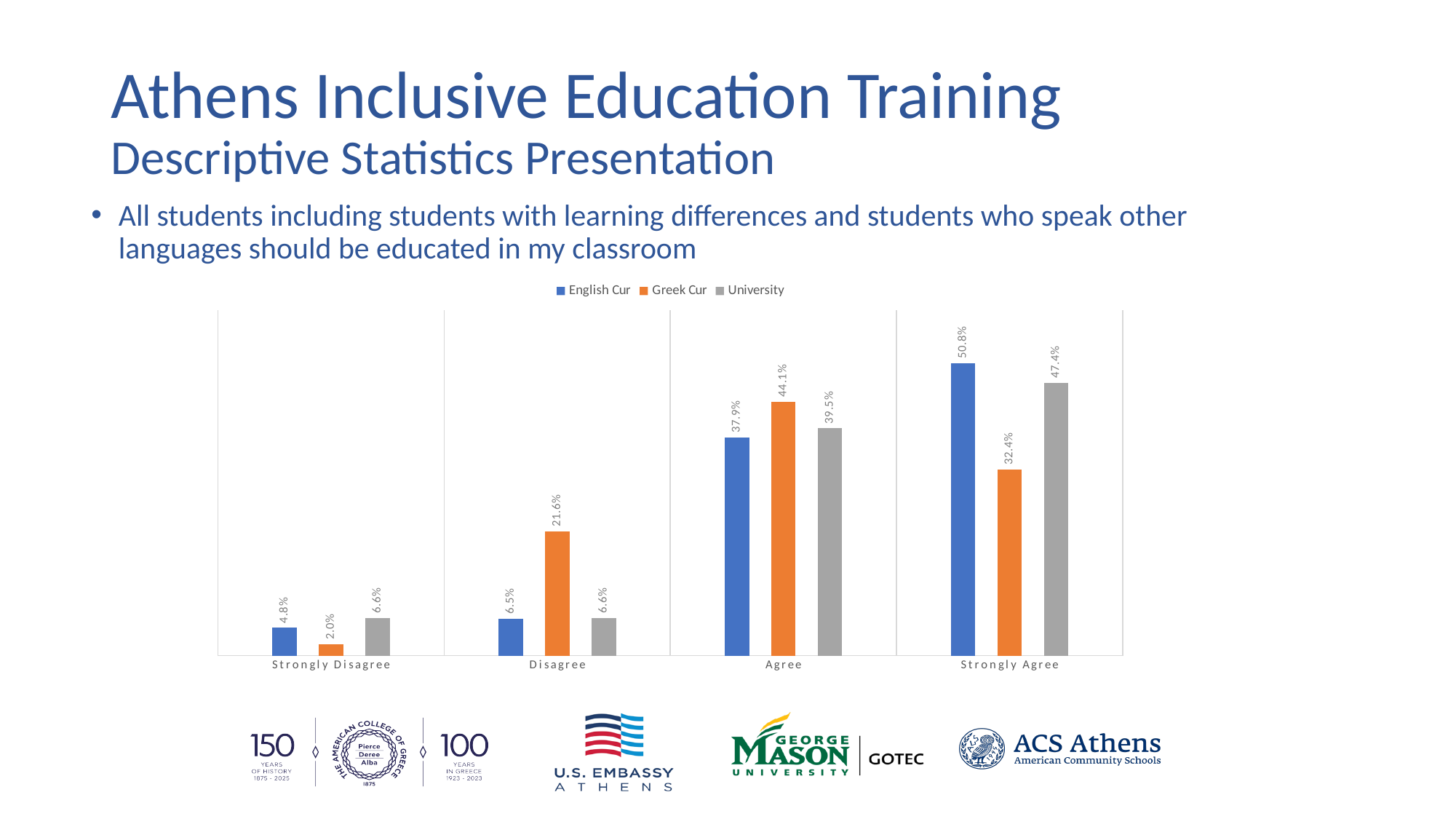
What is the value for University in the Agree category? 39.5% What is the value for Greek Cur in the Disagree category? 21.6% What kind of chart is shown on the slide? Bar chart What is the value for Greek Cur in the Strongly Disagree category? 2.0% How many series does the legend list? 3 What is the difference between the English Cur and Greek Cur values in the Strongly Agree category? 18.4% What is the value for English Cur in the Strongly Agree category? 50.8% In the Agree category, which series has the larger value, English Cur or Greek Cur? Greek Cur How many categories are shown on the x axis? 4 Which category has the highest value for Greek Cur? Agree Which series is shown in orange in the legend? Greek Cur